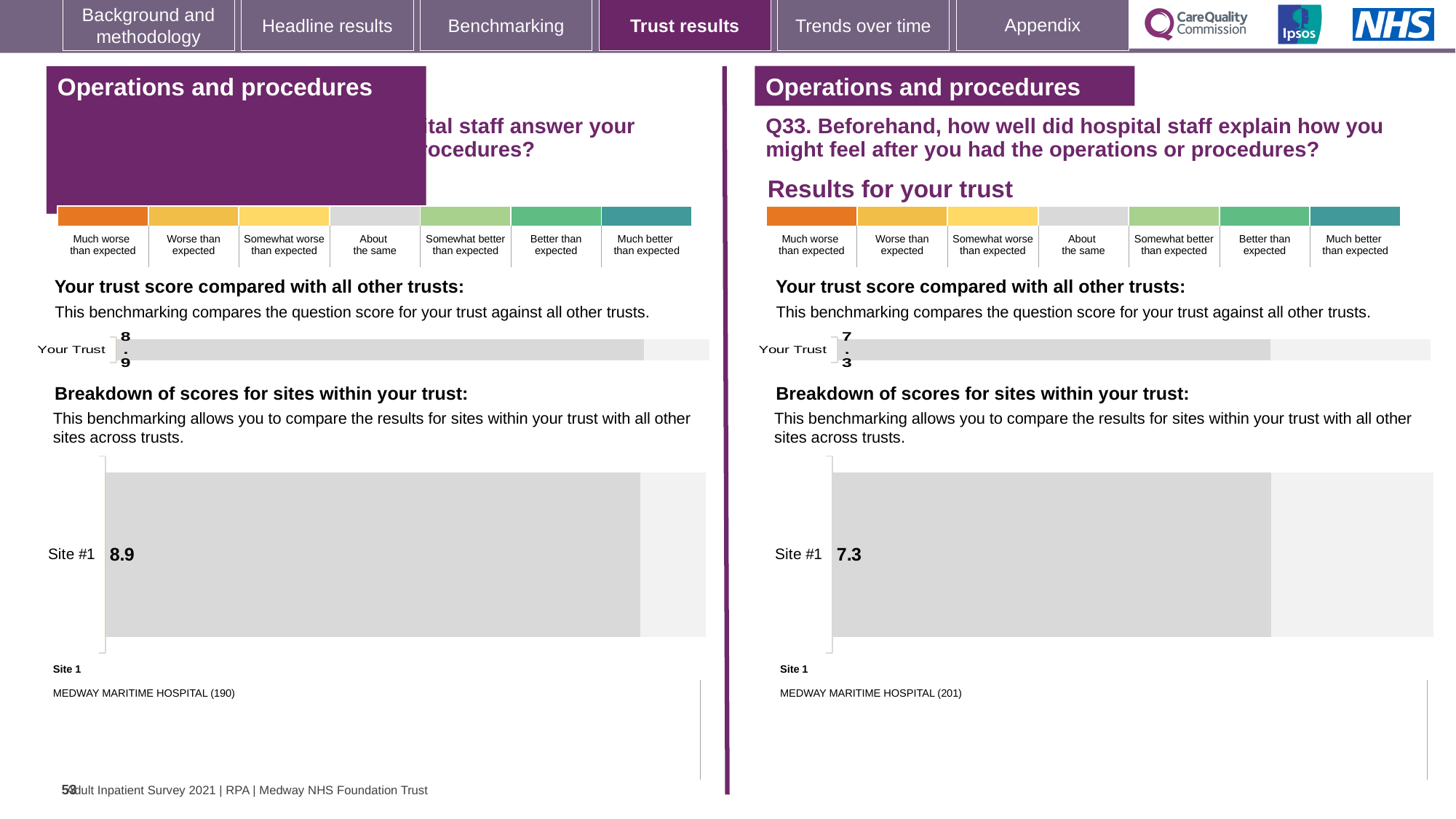
What is the difference between the Your Trust score on the left-hand chart and the Your Trust score on the right-hand (Q33) chart? 1.6 On the right-hand (Q33) breakdown chart, which hospital is Site 1? MEDWAY MARITIME HOSPITAL What is the difference between the Site #1 score on the left-hand breakdown chart and the Site #1 score on the right-hand (Q33) breakdown chart? 1.6 On the left-hand 'Breakdown of scores for sites within your trust' chart, what is the value for Site #1? 8.9 What kind of chart is used for the 'Breakdown of scores for sites within your trust' on the right-hand (Q33) side? bar chart Which has the higher Your Trust score: the left-hand chart or the right-hand (Q33) chart? the left-hand chart On the right-hand (Q33) 'Your trust score compared with all other trusts' chart, what is the value for Your Trust? 7.3 On the left-hand 'Your trust score compared with all other trusts' chart, what is the value for Your Trust? 8.9 On the left-hand breakdown chart, what number is shown in brackets after MEDWAY MARITIME HOSPITAL for Site 1? 190 How many sites are shown in the right-hand (Q33) 'Breakdown of scores for sites within your trust' chart? 1 On the right-hand (Q33) 'Breakdown of scores for sites within your trust' chart, what is the value for Site #1? 7.3